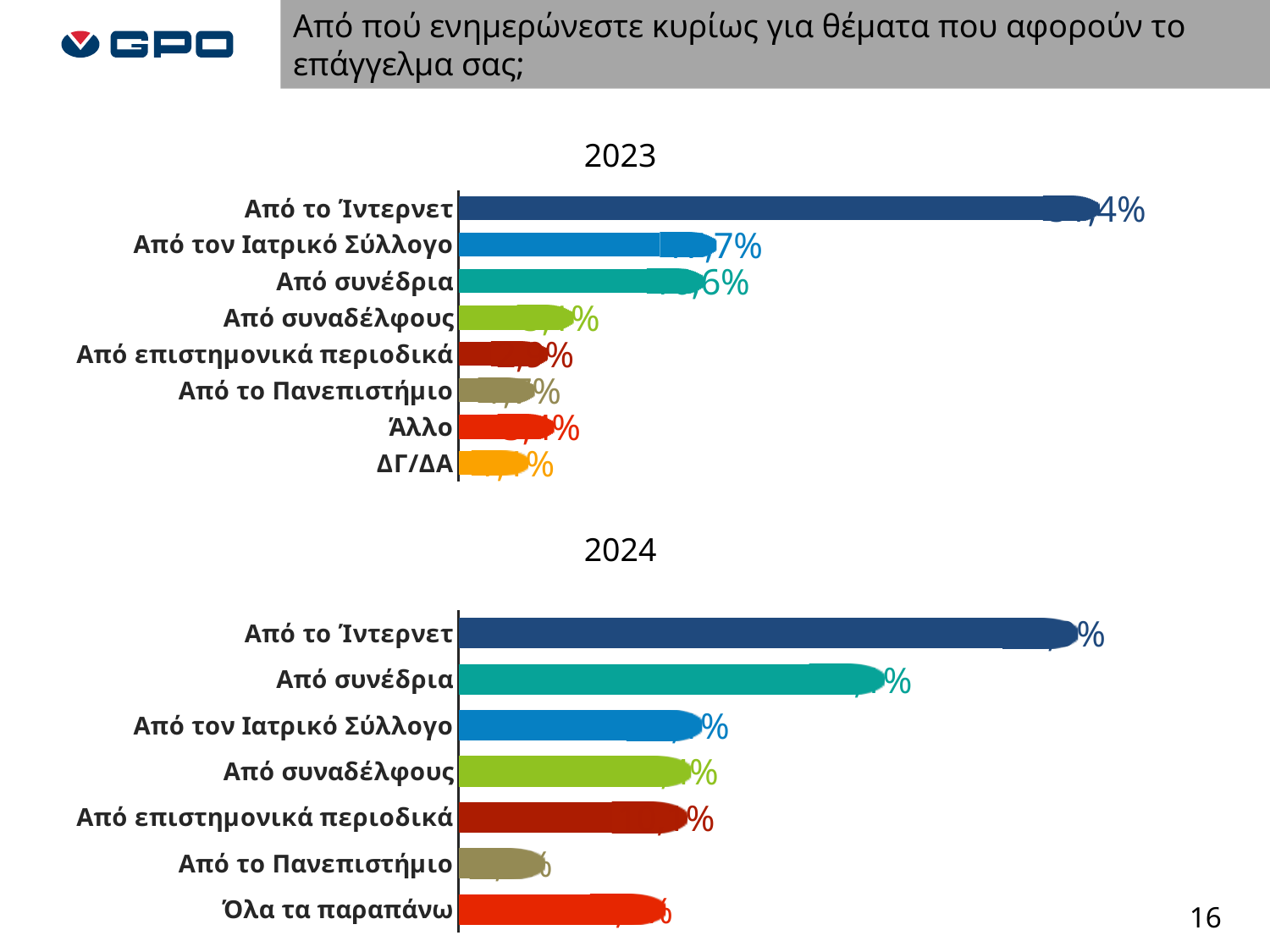
What kind of chart is the 2023 chart? bar chart In the 2024 chart, which category has the lowest value? Από το Πανεπιστήμιο In the 2023 chart, which category has the highest value? Από το Ίντερνετ What are the titles of the two charts on the slide? 2023 and 2024 How many categories does the 2023 chart show? 8 In the 2024 chart, which category has the second highest value? Από συνέδρια In the 2024 chart, which is larger: Από επιστημονικά περιοδικά or Από το Πανεπιστήμιο? Από επιστημονικά περιοδικά What colour is the bar for Από το Ίντερνετ in the 2024 chart? dark blue In the 2024 chart, which is larger: Από συνέδρια or Από τον Ιατρικό Σύλλογο? Από συνέδρια In the 2023 chart, which is larger: Από τον Ιατρικό Σύλλογο or Από συναδέλφους? Από τον Ιατρικό Σύλλογο In the 2024 chart, which category has the highest value? Από το Ίντερνετ How many categories does the 2024 chart show? 7